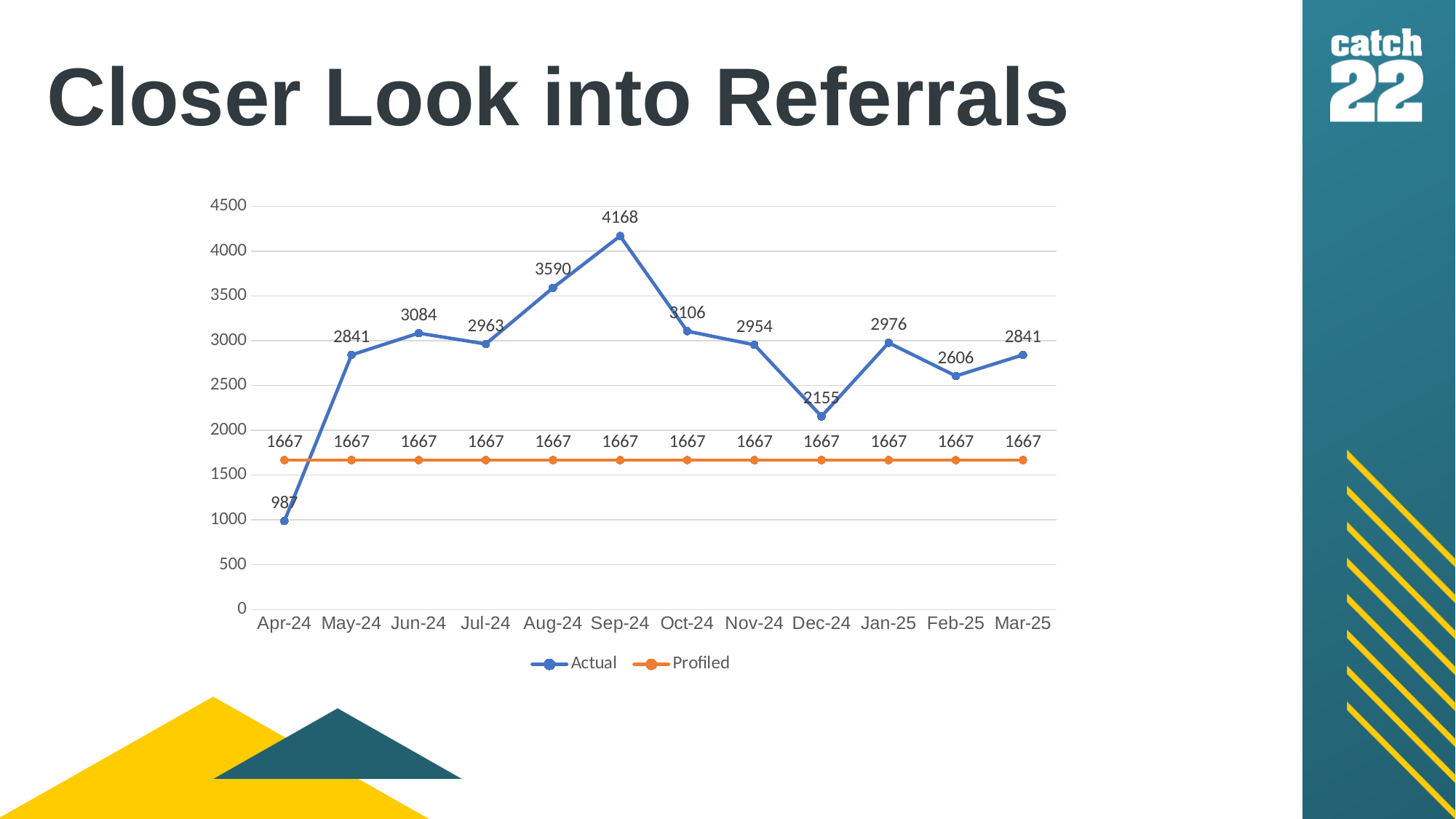
What kind of chart is shown on the slide? Line chart What is the Profiled value for Dec-24? 1667 What is the difference between the Actual value for Sep-24 and the Actual value for Aug-24? 578 What is the Actual value for Apr-24? 987 Does the Actual series rise or fall from Sep-24 to Dec-24? Fall How many series does the legend list? 2 What is the Actual value for Sep-24? 4168 What is the difference between the Actual and Profiled values for Dec-24? 488 Which month has the lowest Actual value? Apr-24 Which month has the highest Actual value? Sep-24 Which is larger, the Actual value for Jun-24 or the Actual value for Jul-24? Jun-24 How many months are plotted on the x axis? 12